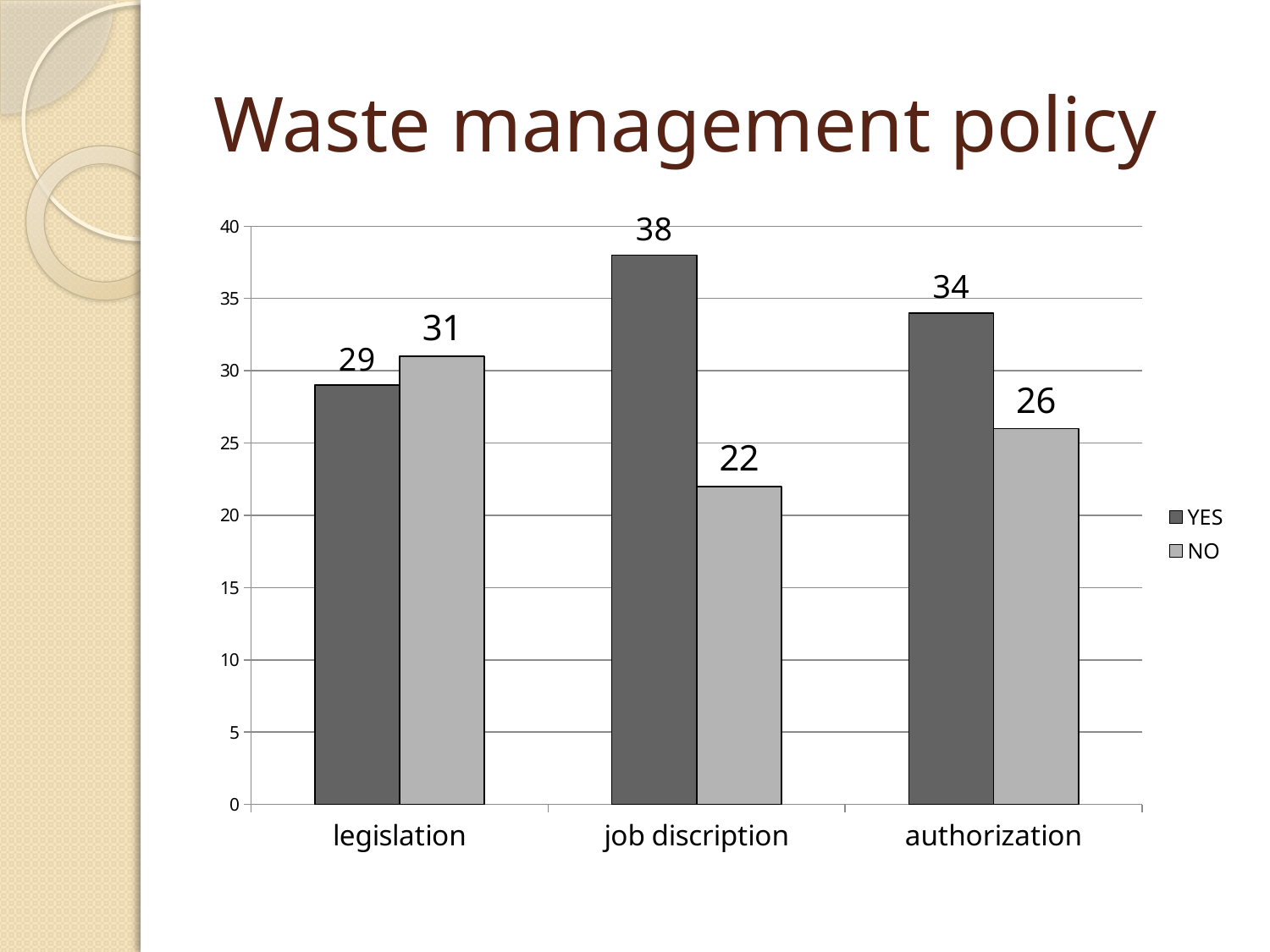
What is the YES value for authorization? 34 What is the YES value for legislation? 29 What kind of chart is shown on the slide? bar chart What is the difference between the YES values for job discription and legislation? 9 Which is larger for legislation, the YES value or the NO value? NO Which category has the lowest NO value? job discription Is the NO value for authorization greater or less than 30? less What is the difference between the YES and NO values for job discription? 16 How many categories are shown on the x axis? 3 What is the NO value for job discription? 22 How many series does the legend list? 2 Which category has the highest YES value? job discription